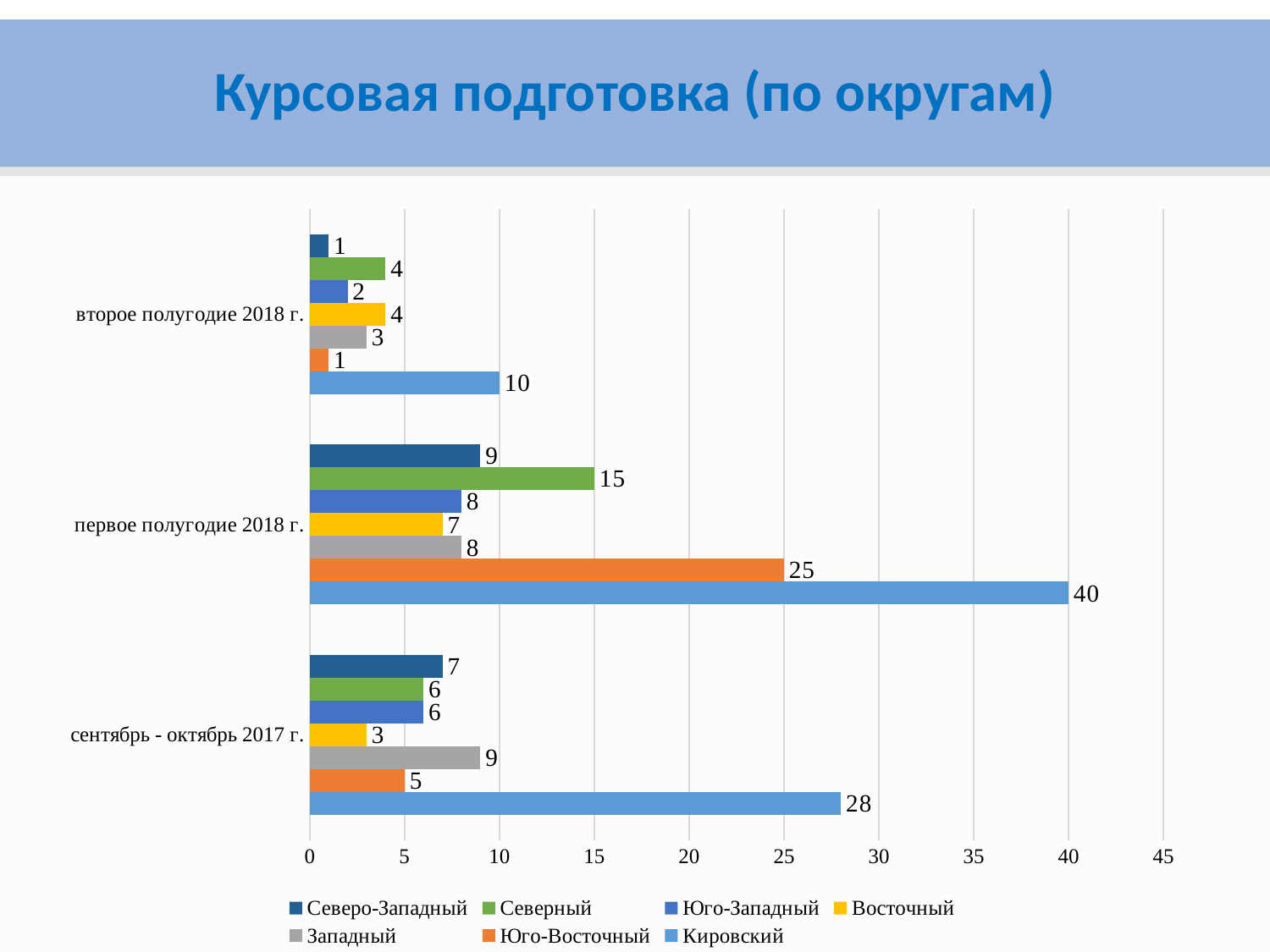
What is the value for Юго-Восточный in сентябрь - октябрь 2017 г.? 5 What is the title of the slide? Курсовая подготовка (по округам) Which district has the highest value in сентябрь - октябрь 2017 г.? Кировский How many series does the legend list? 7 Which district has the lowest value in первое полугодие 2018 г.? Восточный What is the difference between Кировский and Юго-Восточный in первое полугодие 2018 г.? 15 Which is larger in сентябрь - октябрь 2017 г.: Западный or Северо-Западный? Западный What is the value for Северный in второе полугодие 2018 г.? 4 What is the value for Кировский in первое полугодие 2018 г.? 40 Is the value for Кировский in сентябрь - октябрь 2017 г. greater or less than 25? greater What kind of chart is shown on the slide? Bar chart How many time periods are shown on the chart? 3